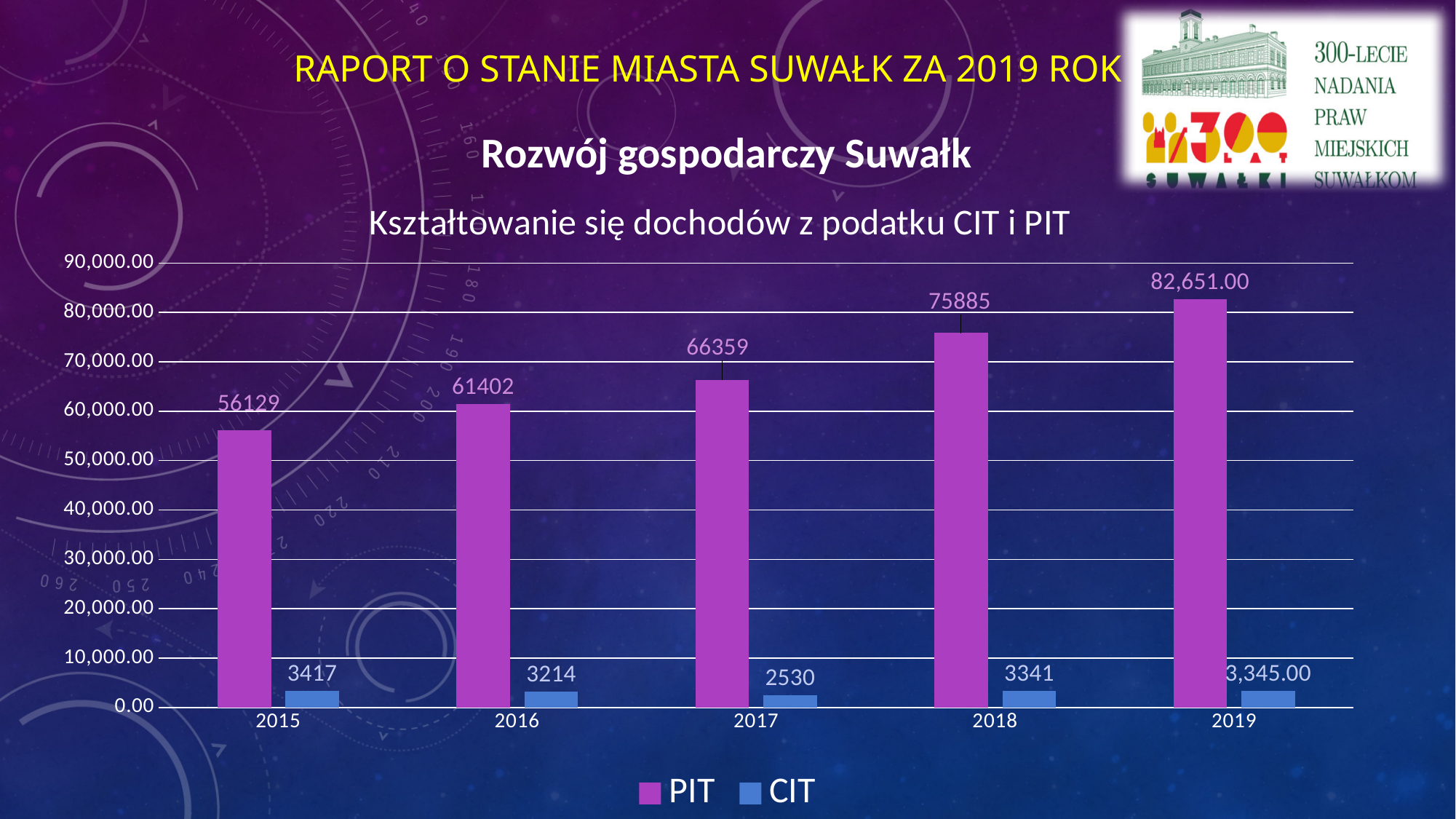
In which year is the CIT value lowest? 2017 What is the CIT value for 2019? 3,345.00 What is the PIT value for 2017? 66359 Do the PIT values rise or fall from 2015 to 2019? rise What is the difference between the PIT values for 2019 and 2018? 6766 How many series does the legend list? 2 In which year is the PIT value highest? 2019 How many years are shown on the x axis? 5 What is the difference between the CIT values for 2015 and 2017? 887 What is the PIT value for 2019? 82,651.00 Which is larger, the CIT value for 2015 or the CIT value for 2017? 2015 What is the CIT value for 2016? 3214